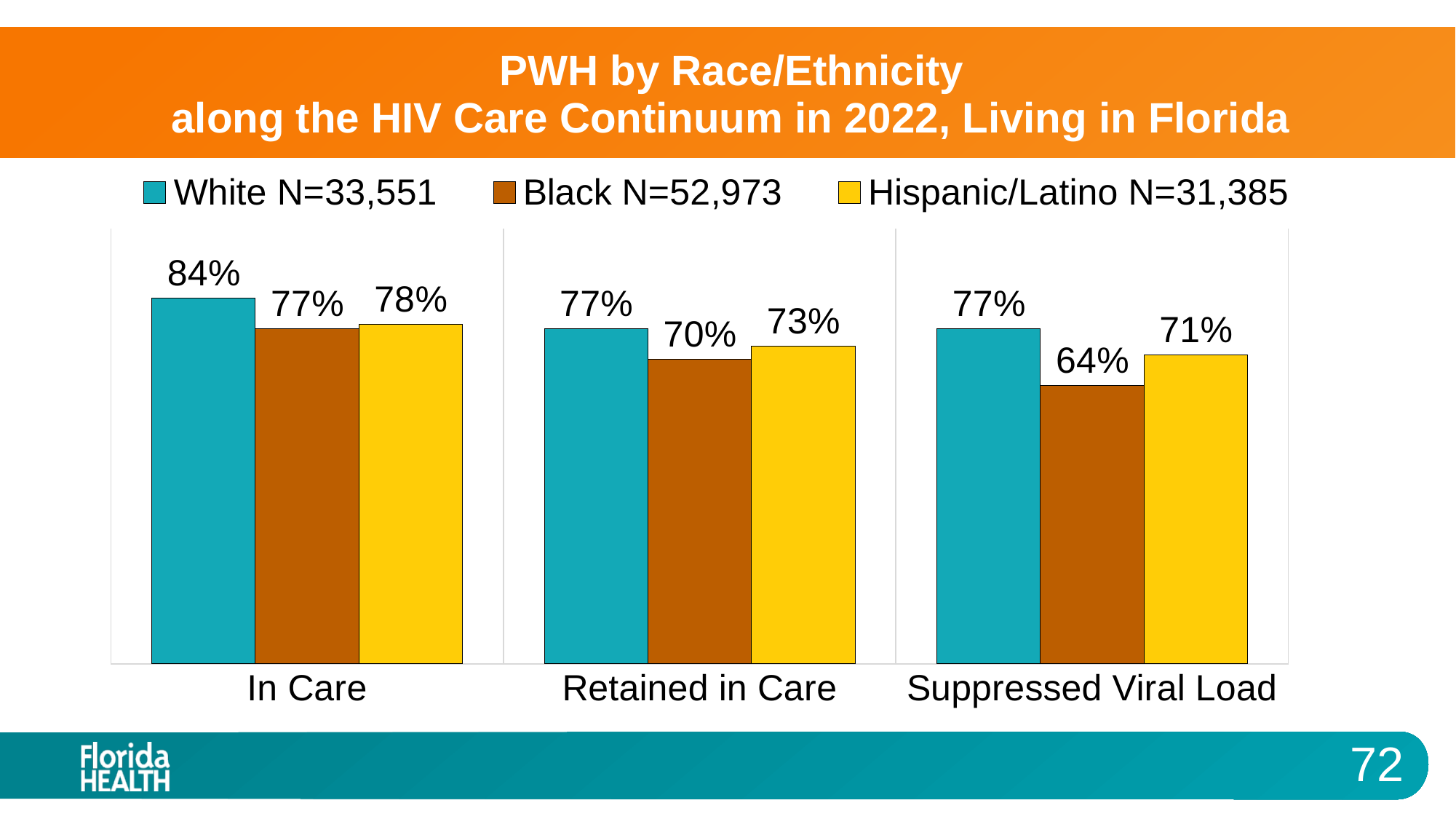
How many series does the legend list? 3 Which race/ethnicity group has the lowest percentage with a Suppressed Viral Load? Black Which race/ethnicity group has the highest percentage In Care? White Which is larger for Retained in Care: the Black percentage or the Hispanic/Latino percentage? Hispanic/Latino What is the difference between the White and Black percentages for Suppressed Viral Load? 13% What kind of chart is shown on the slide? Bar chart What percentage of White PWH are In Care? 84% What is the N value shown in the legend for the Black group? N=52,973 How many care continuum categories are shown on the x axis? 3 What percentage of Black PWH have a Suppressed Viral Load? 64% What percentage of Hispanic/Latino PWH are Retained in Care? 73% Do the percentages for Black PWH rise or fall from In Care to Suppressed Viral Load? Fall